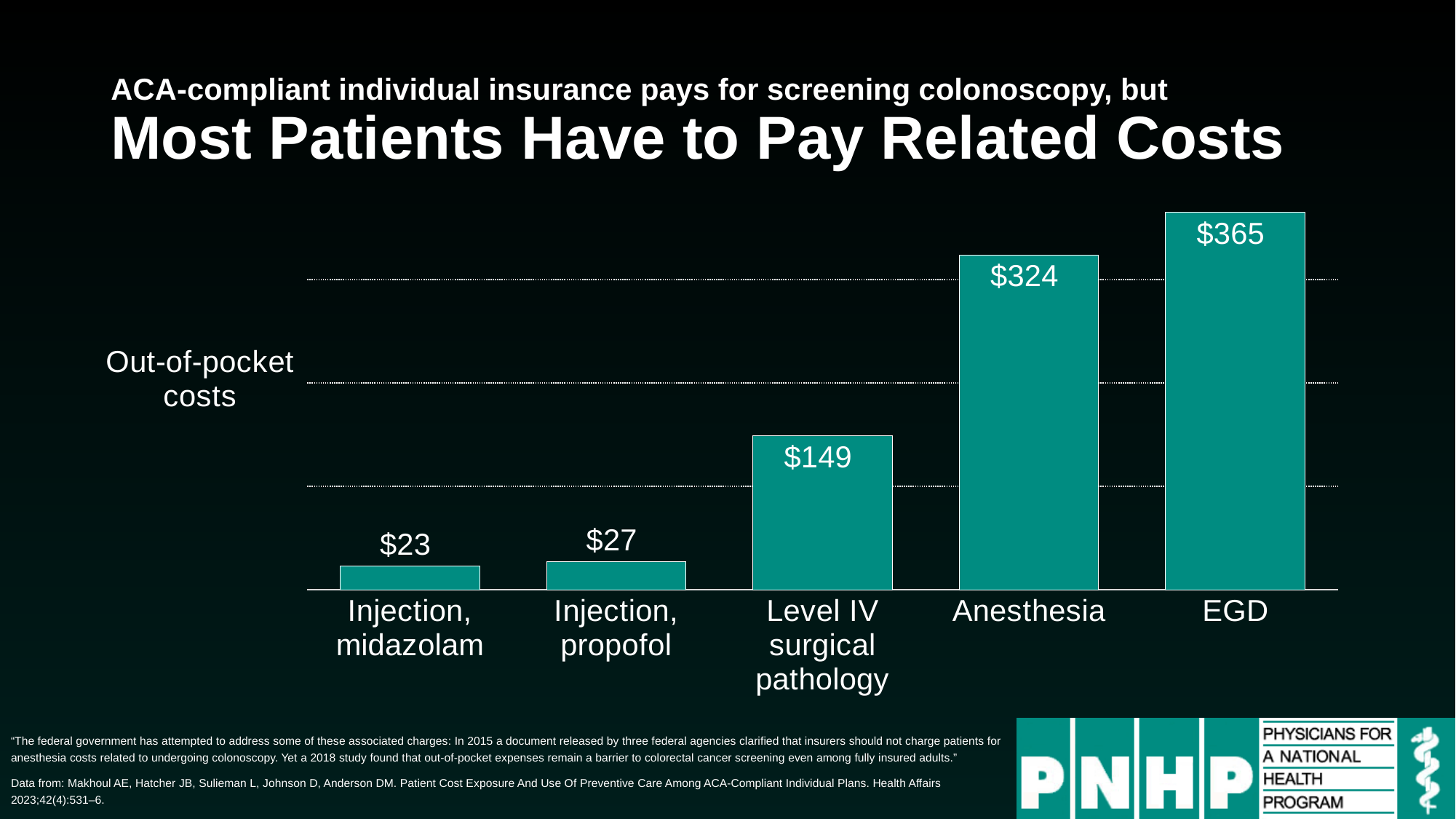
Which category has the highest out-of-pocket cost? EGD What kind of chart is shown on the slide? Bar chart What is the label on the vertical axis of the chart? Out-of-pocket costs What is the out-of-pocket cost for Anesthesia? $324 Do the out-of-pocket costs rise or fall from left to right across the categories? Rise What is the out-of-pocket cost for Level IV surgical pathology? $149 Which category has the lowest out-of-pocket cost? Injection, midazolam What is the out-of-pocket cost for Injection, midazolam? $23 What is the difference in out-of-pocket cost between EGD and Anesthesia? $41 Which has a higher out-of-pocket cost, Level IV surgical pathology or Anesthesia? Anesthesia How many categories are shown in the chart? 5 What is the difference in out-of-pocket cost between Injection, propofol and Injection, midazolam? $4